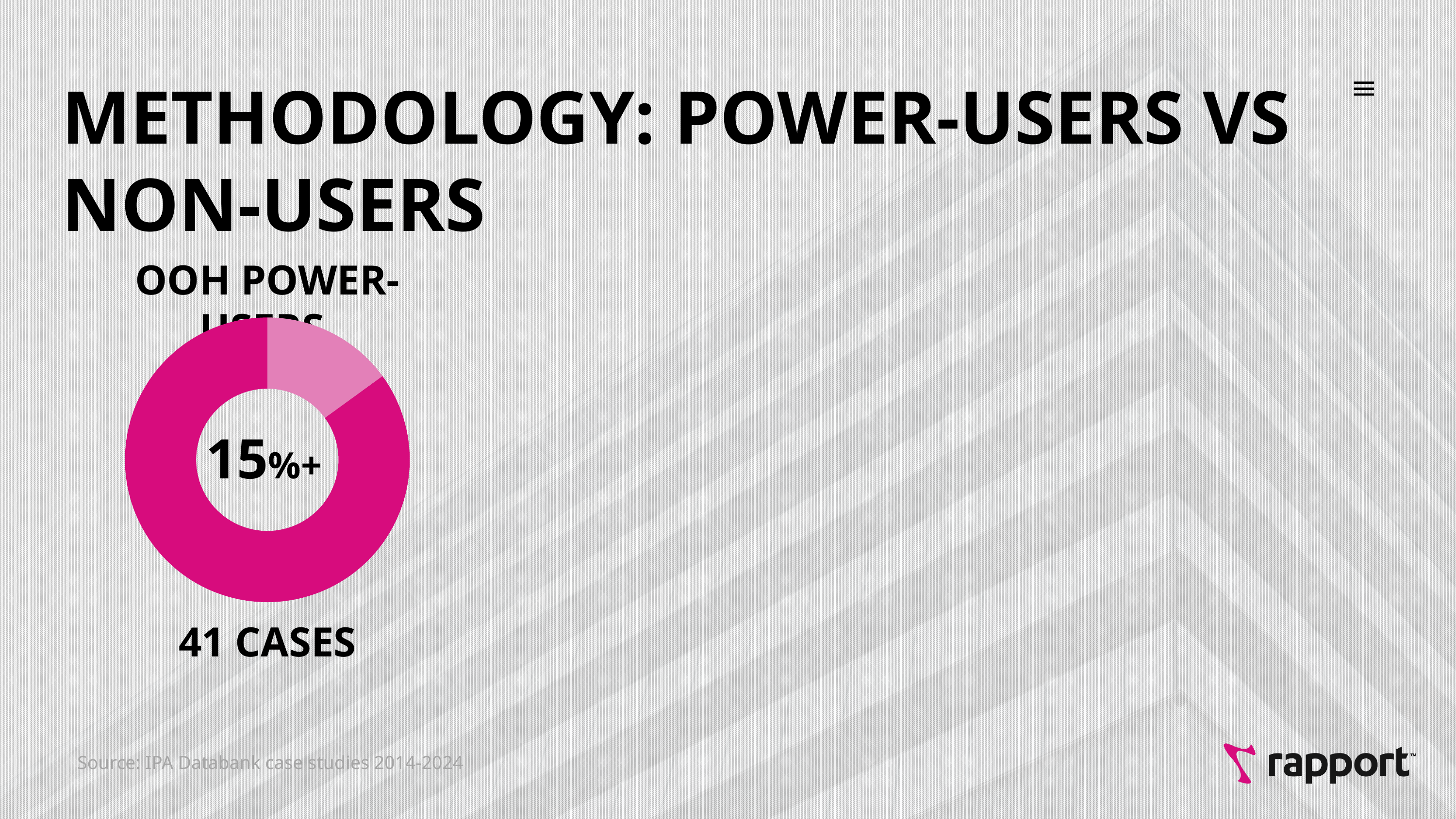
What source is cited for the chart data at the bottom of the slide? IPA Databank case studies 2014-2024 Which slice of the donut chart is larger, the dark magenta slice or the light pink slice? The dark magenta slice What value is printed in the centre of the donut chart? 15%+ How many slices does the donut chart have? 2 What kind of chart is shown on the slide? Donut (pie) chart What is the title shown above the donut chart? OOH POWER-USERS How many cases does the label below the donut chart say the chart is based on? 41 CASES